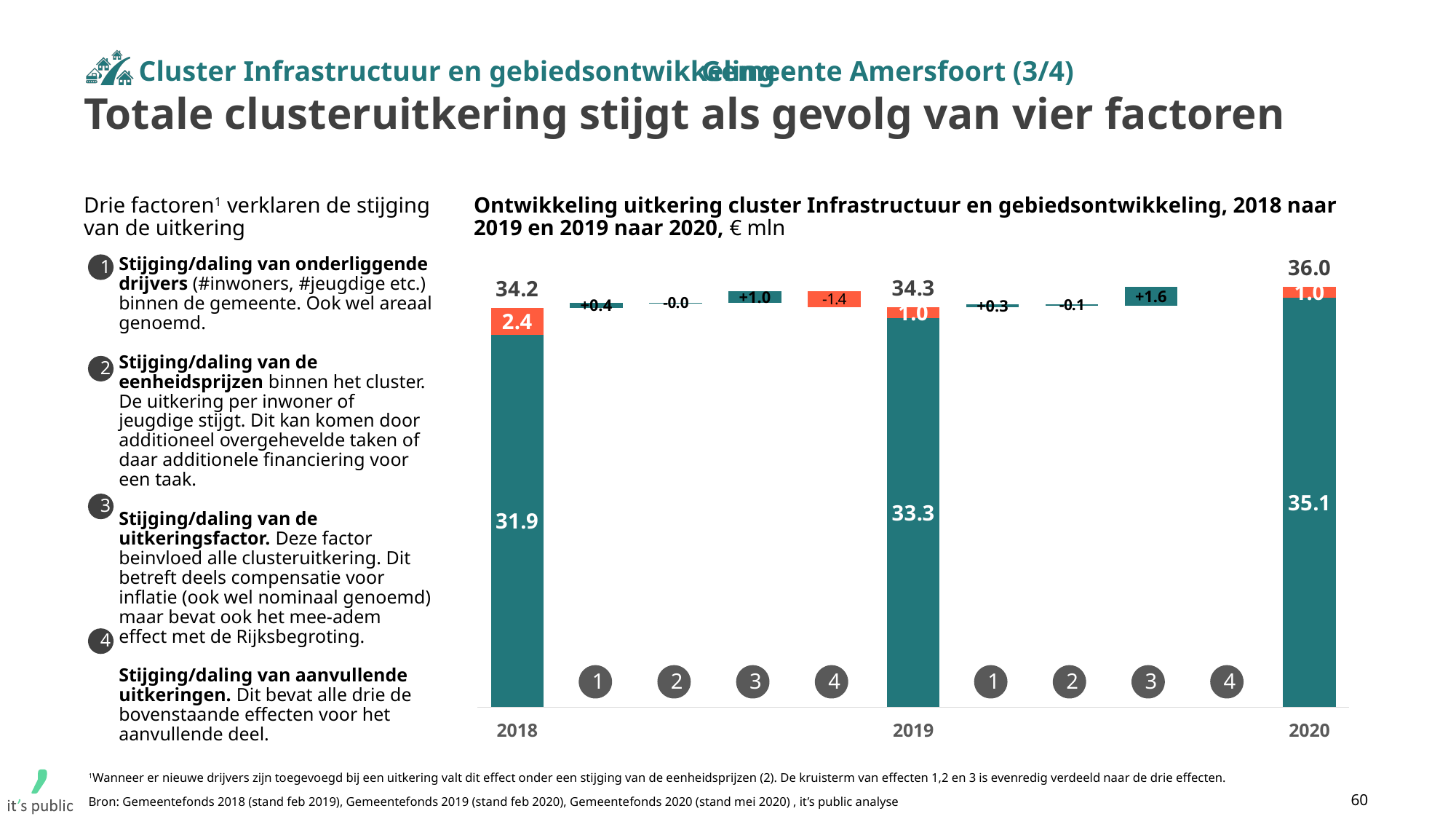
What is the effect of factor 1 between 2018 and 2019? +0.4 What unit is the chart expressed in, according to its title? € mln Is the total for 2019 larger or smaller than the total for 2020? smaller What is the effect of factor 3 between 2019 and 2020? +1.6 What is the value of the large teal segment of the 2019 bar? 33.3 What is the value of the orange (top) segment of the 2018 bar? 2.4 Does the total uitkering rise or fall from 2018 to 2020? rise Which year has the highest total uitkering? 2020 What is the total uitkering shown for 2018? 34.2 What is the effect of factor 4 between 2018 and 2019? -1.4 What is the difference between the total for 2020 and the total for 2018? 1.8 What is the total uitkering shown for 2020? 36.0